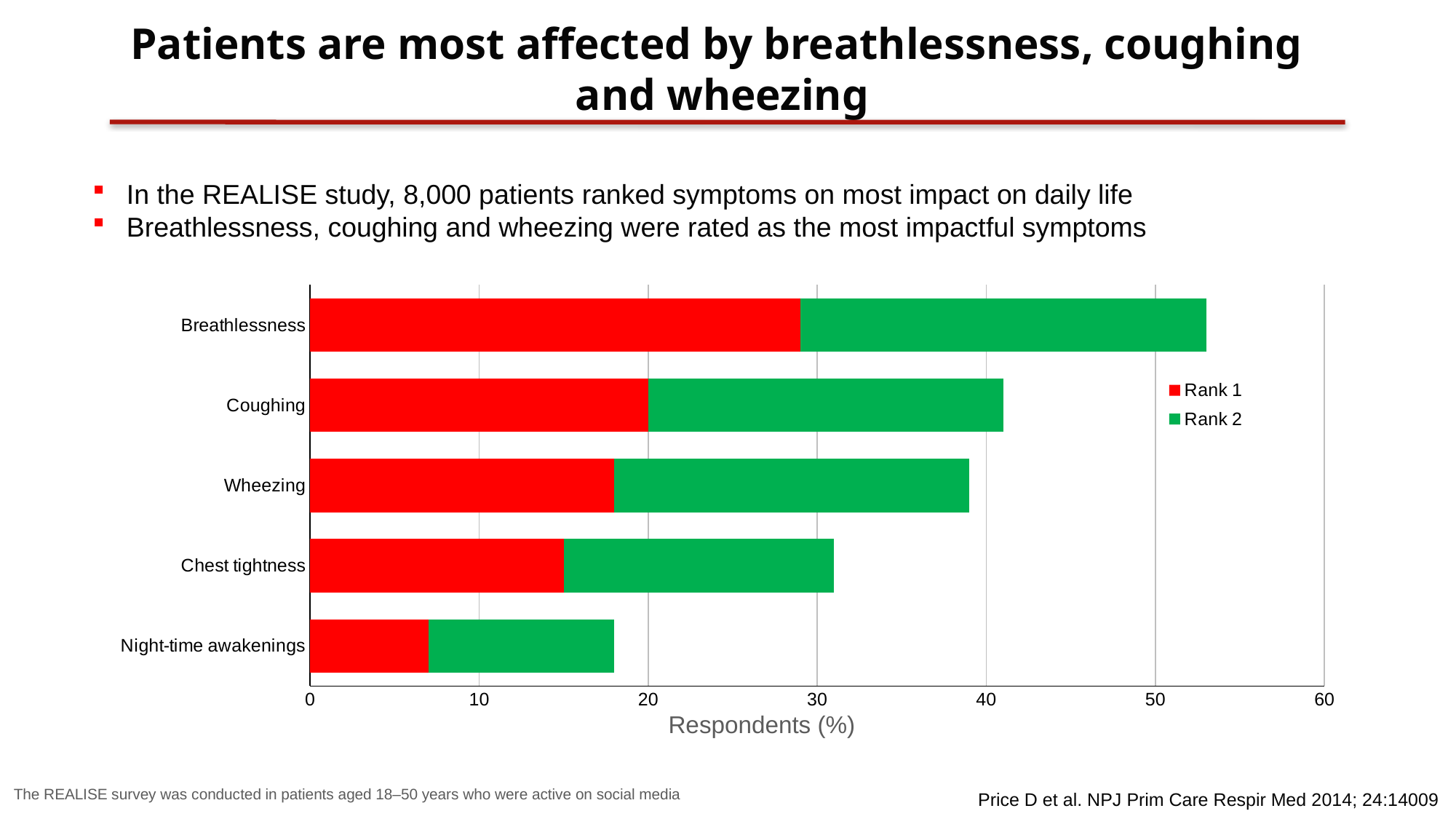
Is the Rank 1 value for Night-time awakenings greater or less than 10? less What is the label of the horizontal axis? Respondents (%) Which symptom has the shortest total bar (Rank 1 plus Rank 2)? Night-time awakenings How many series does the chart legend list? 2 Is the total bar for Breathlessness greater or less than 50? greater What kind of chart is shown on the slide? Stacked bar chart Which has the larger Rank 1 value, Coughing or Chest tightness? Coughing Which has the larger total bar, Breathlessness or Chest tightness? Breathlessness Is the total bar for Night-time awakenings greater or less than 20? less How many symptom categories are plotted on the chart? 5 Which symptom has the longest total bar (Rank 1 plus Rank 2)? Breathlessness